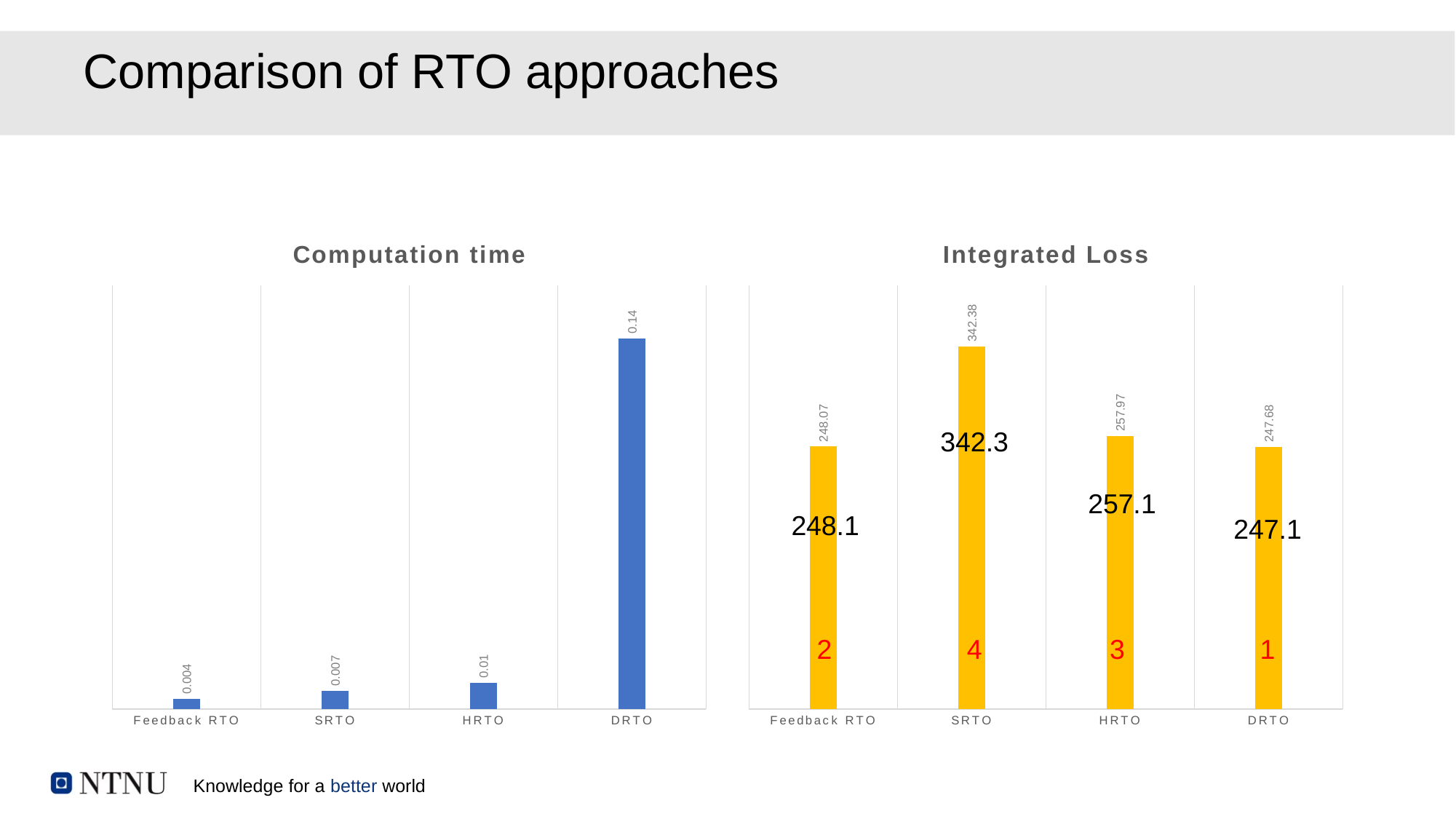
In the Computation time chart, what is the value for DRTO? 0.14 In the Integrated Loss chart, what is the data label value for SRTO? 342.38 What type of chart is the Integrated Loss chart? bar chart In the Computation time chart, what is the value for Feedback RTO? 0.004 In the Computation time chart, which approach has the highest computation time? DRTO In the Integrated Loss chart, which approach has the highest integrated loss? SRTO In the Computation time chart, what is the difference between the values for DRTO and SRTO? 0.133 In the Computation time chart, which approach has the lowest computation time? Feedback RTO In the Computation time chart, what is the value for HRTO? 0.01 How many categories are shown in the Computation time chart? 4 In the Integrated Loss chart, what is the data label value for DRTO? 247.68 In the Integrated Loss chart, is the value for SRTO larger or smaller than the value for HRTO? larger